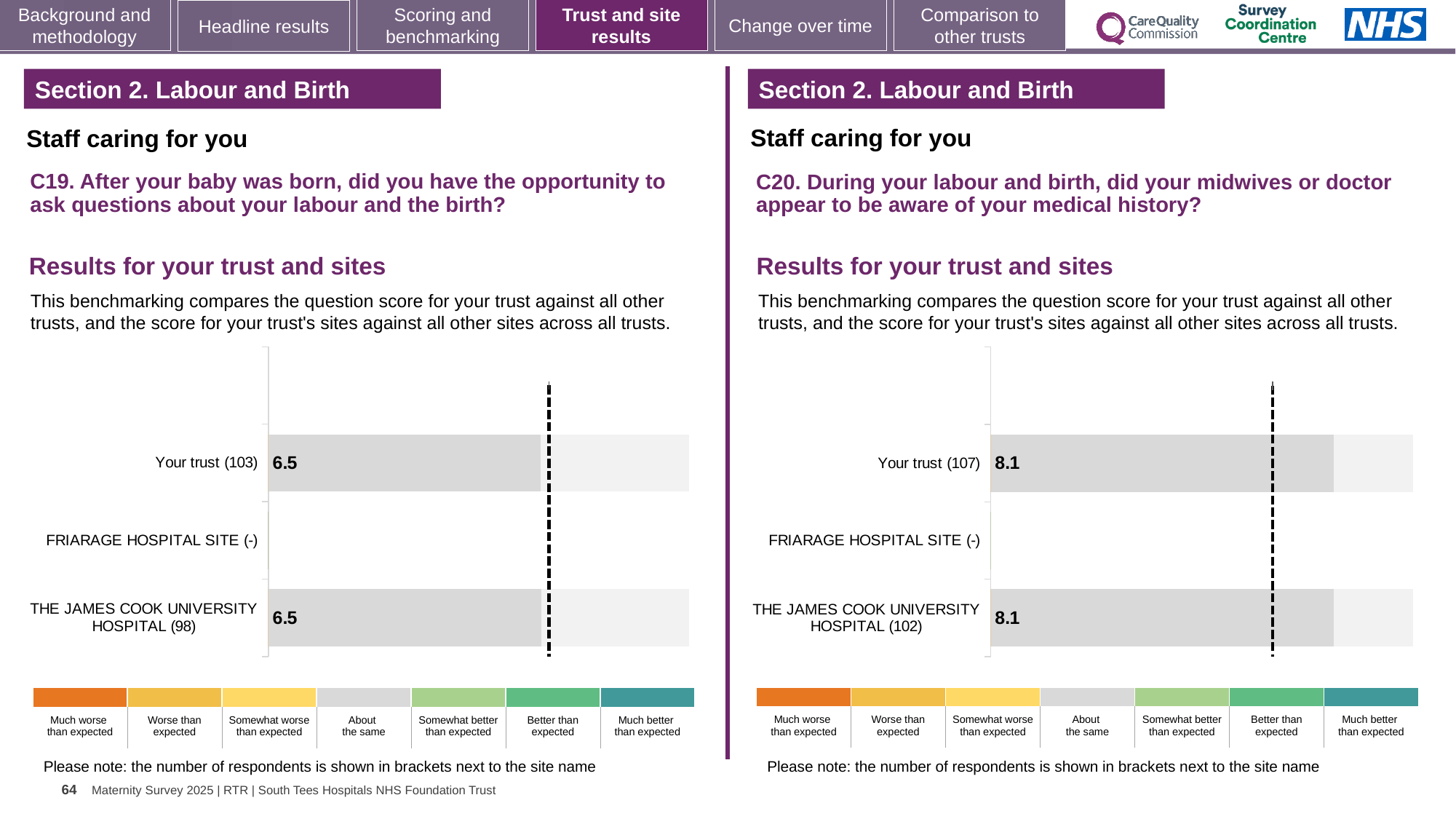
How many categories (rows) are listed in the C19 chart on the left? 3 In the C20 chart on the right, what is the score for Your trust (107)? 8.1 In the C20 chart on the right, what is the difference between the score for Your trust and the score for THE JAMES COOK UNIVERSITY HOSPITAL? 0 In the C19 chart on the left, what is the score for Your trust (103)? 6.5 How many categories (rows) are listed in the C20 chart on the right? 3 In the C20 chart on the right, what is the score for THE JAMES COOK UNIVERSITY HOSPITAL (102)? 8.1 In the C19 chart on the left, how many respondents are shown in brackets for Your trust? 103 In the C20 chart on the right, how many respondents are shown in brackets for THE JAMES COOK UNIVERSITY HOSPITAL? 102 In the C19 chart on the left, what is the score for THE JAMES COOK UNIVERSITY HOSPITAL (98)? 6.5 In the C20 chart on the right, which category has no bar plotted? FRIARAGE HOSPITAL SITE (-) In the C19 chart on the left, what is the difference between the score for Your trust and the score for THE JAMES COOK UNIVERSITY HOSPITAL? 0 What kind of chart is the C19 chart on the left? Bar chart